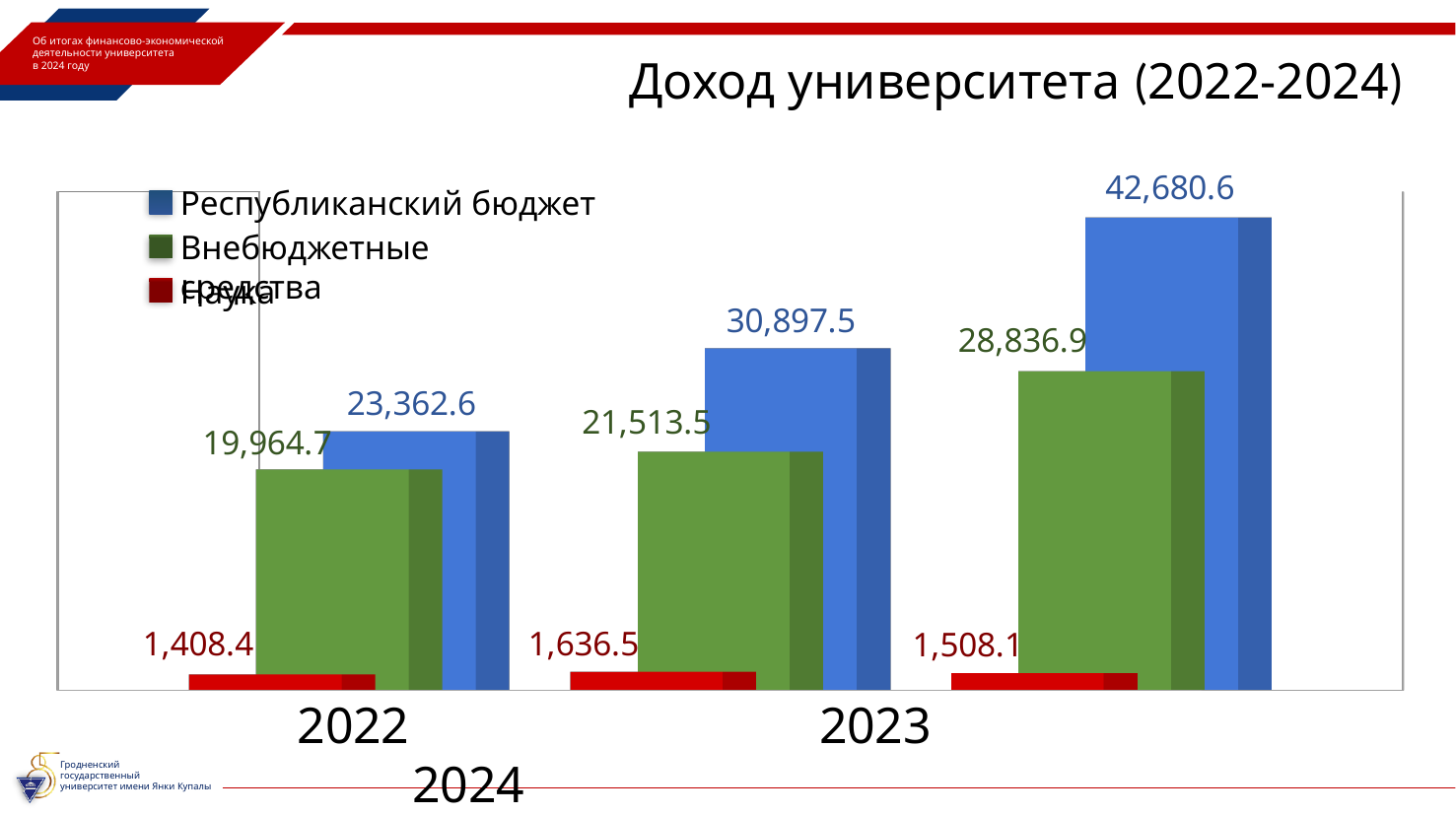
What type of chart is shown on the slide? bar chart Does Республиканский бюджет rise or fall from 2022 to 2024? rise Which is larger in 2024: Республиканский бюджет or Внебюджетные средства? Республиканский бюджет What is the difference between Республиканский бюджет in 2024 and in 2022? 19,318.0 What is the value of Наука for 2023? 1,636.5 How many series does the legend list? 3 What is the value of Республиканский бюджет for 2024? 42,680.6 In which year is Республиканский бюджет the highest? 2024 What is the value of Внебюджетные средства for 2022? 19,964.7 What is the difference between Республиканский бюджет and Внебюджетные средства in 2023? 9,384.0 How many years (categories) are shown on the x axis? 3 In which year is Наука the lowest? 2022